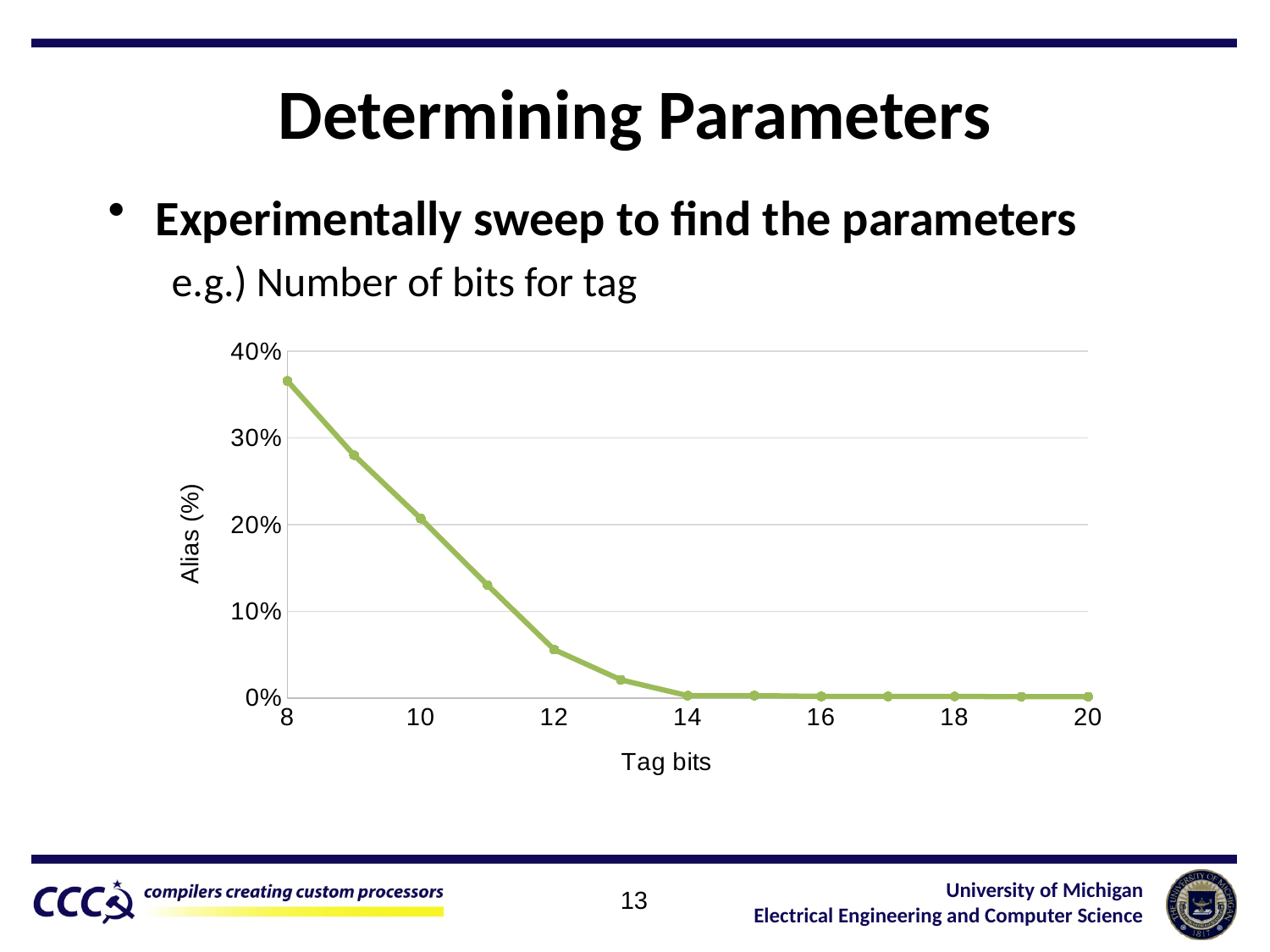
Is the alias value at 11 tag bits greater or less than 10%? greater Is the alias value at 9 tag bits greater or less than 30%? less What is the label of the y axis of the chart? Alias (%) What is the label of the x axis of the chart? Tag bits Is the alias value at 8 tag bits greater or less than 30%? greater What kind of chart is shown on the slide? line chart At which number of tag bits is the alias percentage highest? 8 Do the alias values rise or fall as the number of tag bits increases along the x axis? fall Which has a higher alias percentage: 10 tag bits or 13 tag bits? 10 tag bits How many data points are plotted on the line? 13